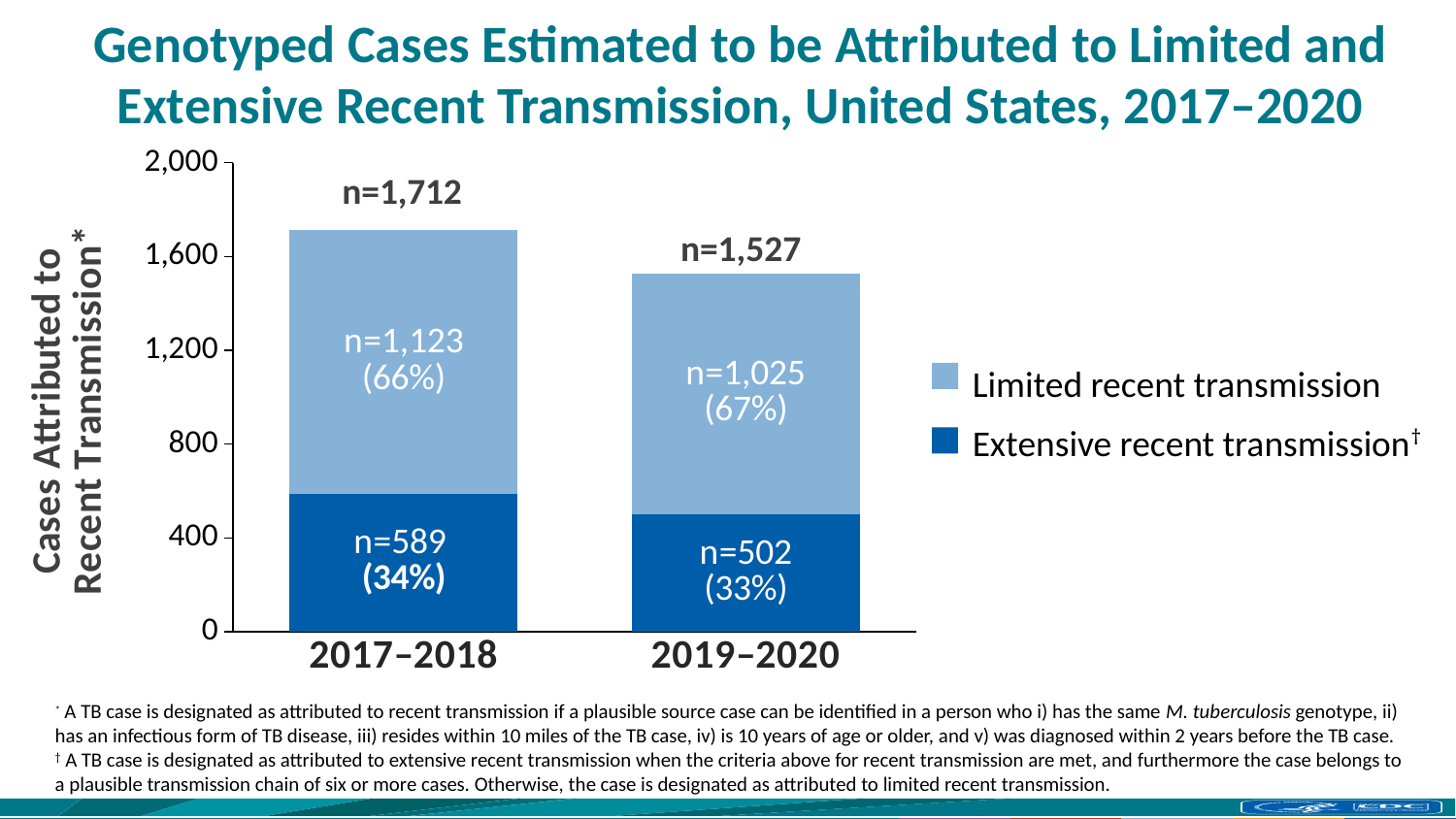
What kind of chart is shown on the slide? Stacked bar chart Which colour represents extensive recent transmission in the chart? Dark blue How many time periods (categories) are shown on the x axis? 2 What is the number of cases attributed to extensive recent transmission in 2019–2020? n=502 What percentage of cases in 2019–2020 were attributed to limited recent transmission? 67% How many series does the legend list? 2 Which period has the higher total number of cases attributed to recent transmission? 2017–2018 What is the total number of genotyped cases attributed to recent transmission in 2019–2020? n=1,527 What is the difference between the number of extensive recent transmission cases in 2017–2018 and in 2019–2020? 87 What is the number of cases attributed to limited recent transmission in 2017–2018? n=1,123 Is the total for 2019–2020 greater or less than 1,600? less What is the total number of genotyped cases attributed to recent transmission in 2017–2018? n=1,712